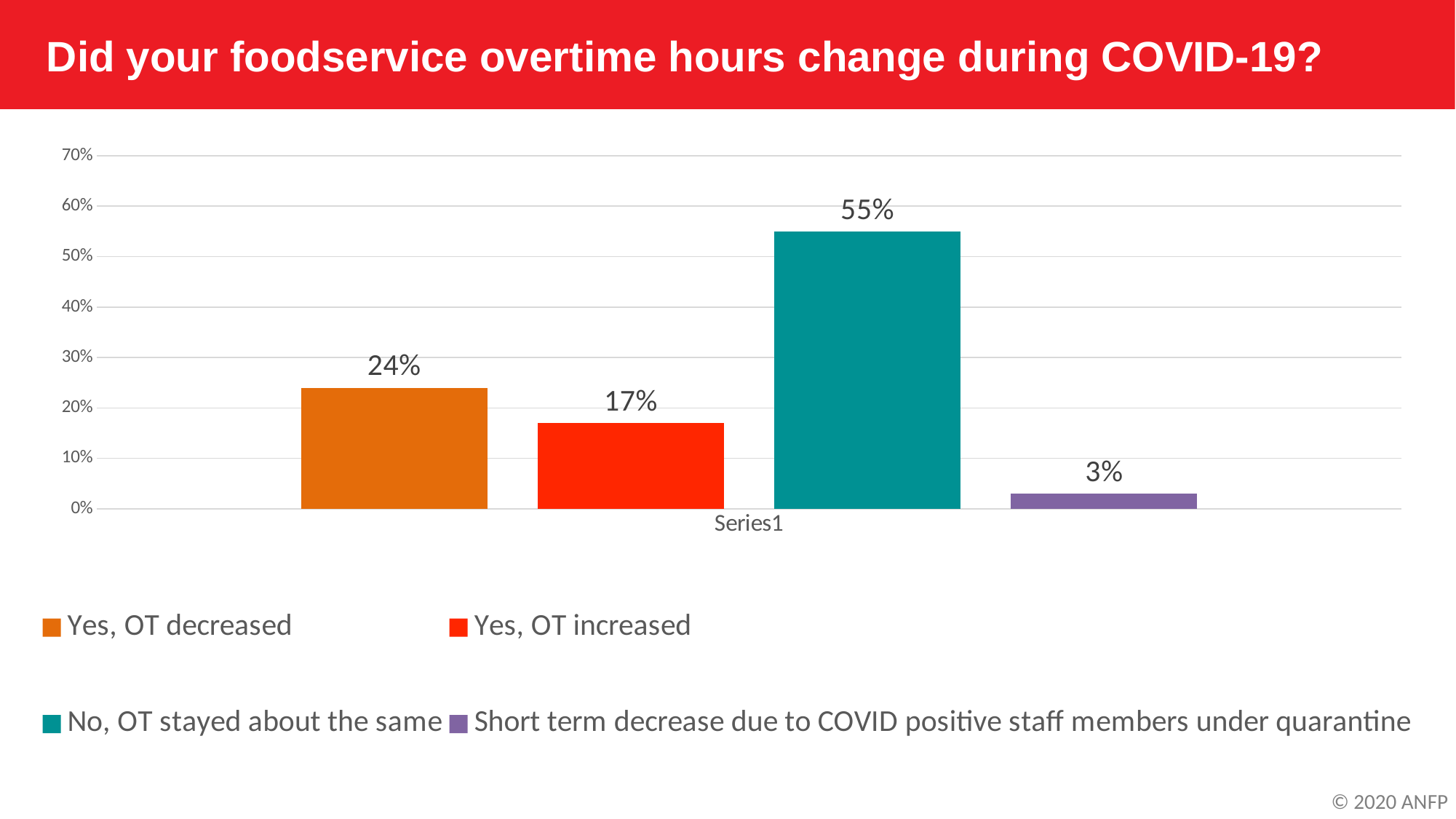
What is the difference in percentage points between 'No, OT stayed about the same' and 'Yes, OT decreased'? 31 percentage points What is the difference in percentage points between 'Yes, OT decreased' and 'Yes, OT increased'? 7 percentage points What percentage of respondents reported a short term decrease due to COVID positive staff members under quarantine? 3% How many response categories are shown in the chart? 4 What percentage of respondents said 'Yes, OT increased'? 17% What is the title of the chart? Did your foodservice overtime hours change during COVID-19? Which response has the lowest percentage? Short term decrease due to COVID positive staff members under quarantine What percentage of respondents said 'No, OT stayed about the same'? 55% What percentage of respondents said 'Yes, OT decreased'? 24% Which is larger: 'Yes, OT decreased' or 'Yes, OT increased'? Yes, OT decreased Which response has the highest percentage? No, OT stayed about the same What type of chart is shown on the slide? Bar chart